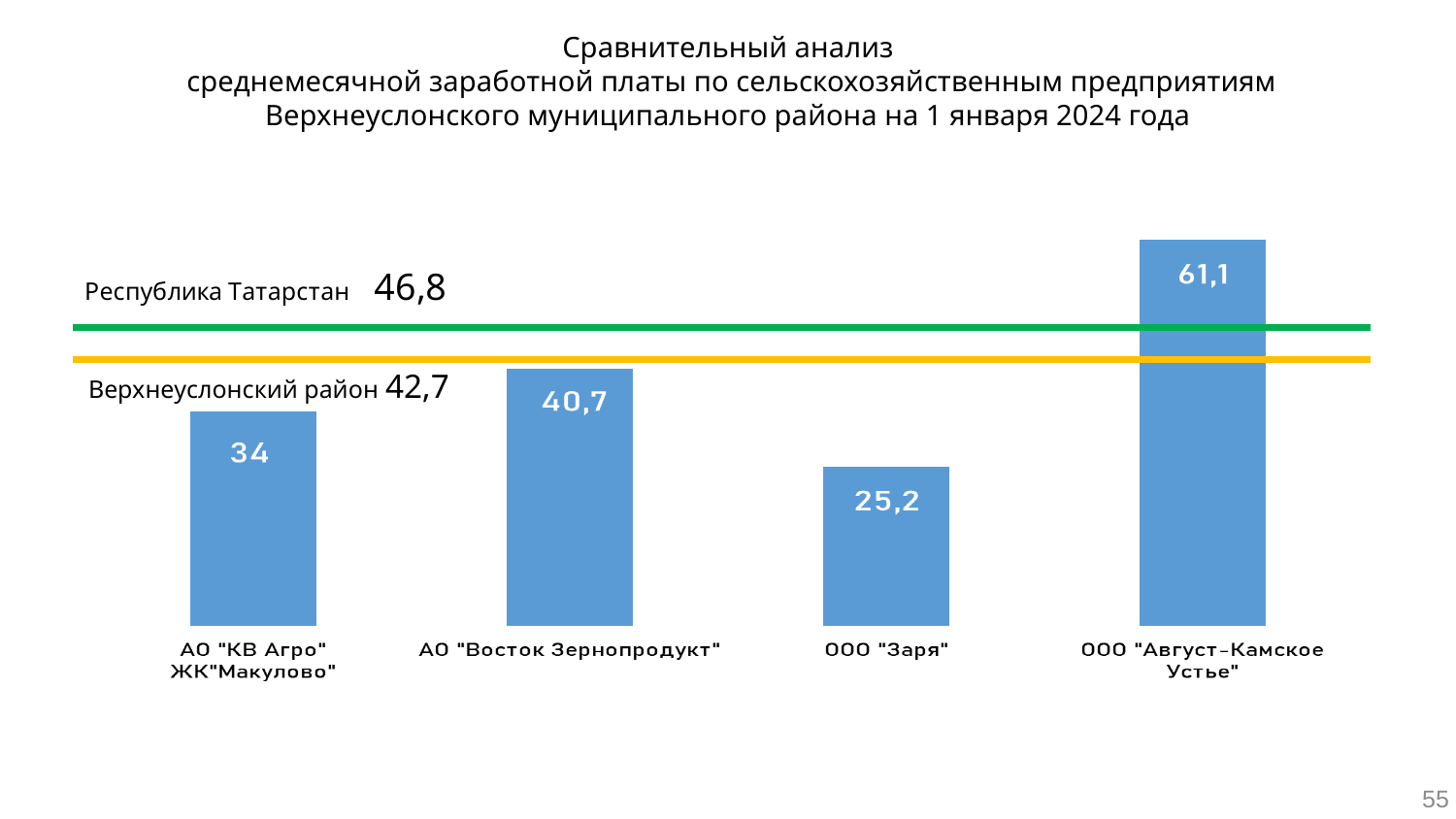
What is the difference between the values for АО "Восток Зернопродукт" and АО "КВ Агро" ЖК"Макулово"? 6,7 Which is larger, the value for АО "Восток Зернопродукт" or the value for АО "КВ Агро" ЖК"Макулово"? АО "Восток Зернопродукт" What is the value for АО "КВ Агро" ЖК"Макулово"? 34 What is the difference between the values for ООО "Август-Камское Устье" and ООО "Заря"? 35,9 What is the value for ООО "Заря"? 25,2 Which enterprise has the lowest average monthly salary? ООО "Заря" What is the value for АО "Восток Зернопродукт"? 40,7 Which enterprise has the highest average monthly salary? ООО "Август-Камское Устье" What kind of chart is shown on the slide? Bar chart What value is shown for the reference line labelled Республика Татарстан? 46,8 What is the value for ООО "Август-Камское Устье"? 61,1 How many enterprises are shown as bars in the chart? 4